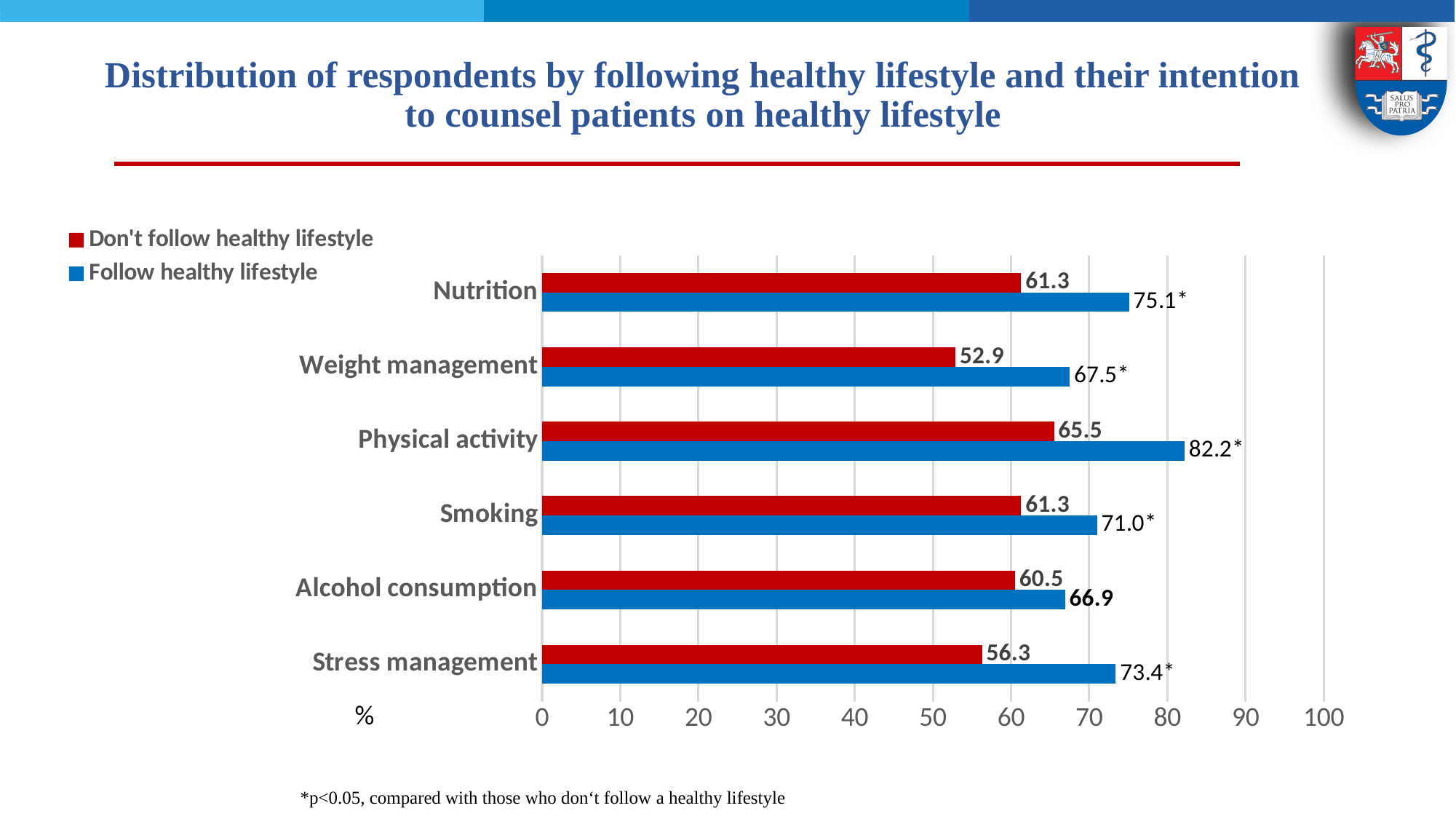
What is the value for 'Don't follow healthy lifestyle' for Weight management? 52.9 What is the difference between the 'Follow healthy lifestyle' and 'Don't follow healthy lifestyle' values for Physical activity? 16.7 Which category has the highest value for 'Follow healthy lifestyle'? Physical activity Which colour represents the 'Follow healthy lifestyle' series? Blue What is the value for 'Follow healthy lifestyle' for Physical activity? 82.2 What is the difference between the 'Follow healthy lifestyle' and 'Don't follow healthy lifestyle' values for Stress management? 17.1 How many categories are shown on the chart? 6 Which category has the lowest value for 'Don't follow healthy lifestyle'? Weight management What is the value for 'Follow healthy lifestyle' for Alcohol consumption? 66.9 What kind of chart is shown on the slide? Bar chart How many series does the legend list? 2 Which is larger: the 'Follow healthy lifestyle' value for Nutrition or for Smoking? Nutrition